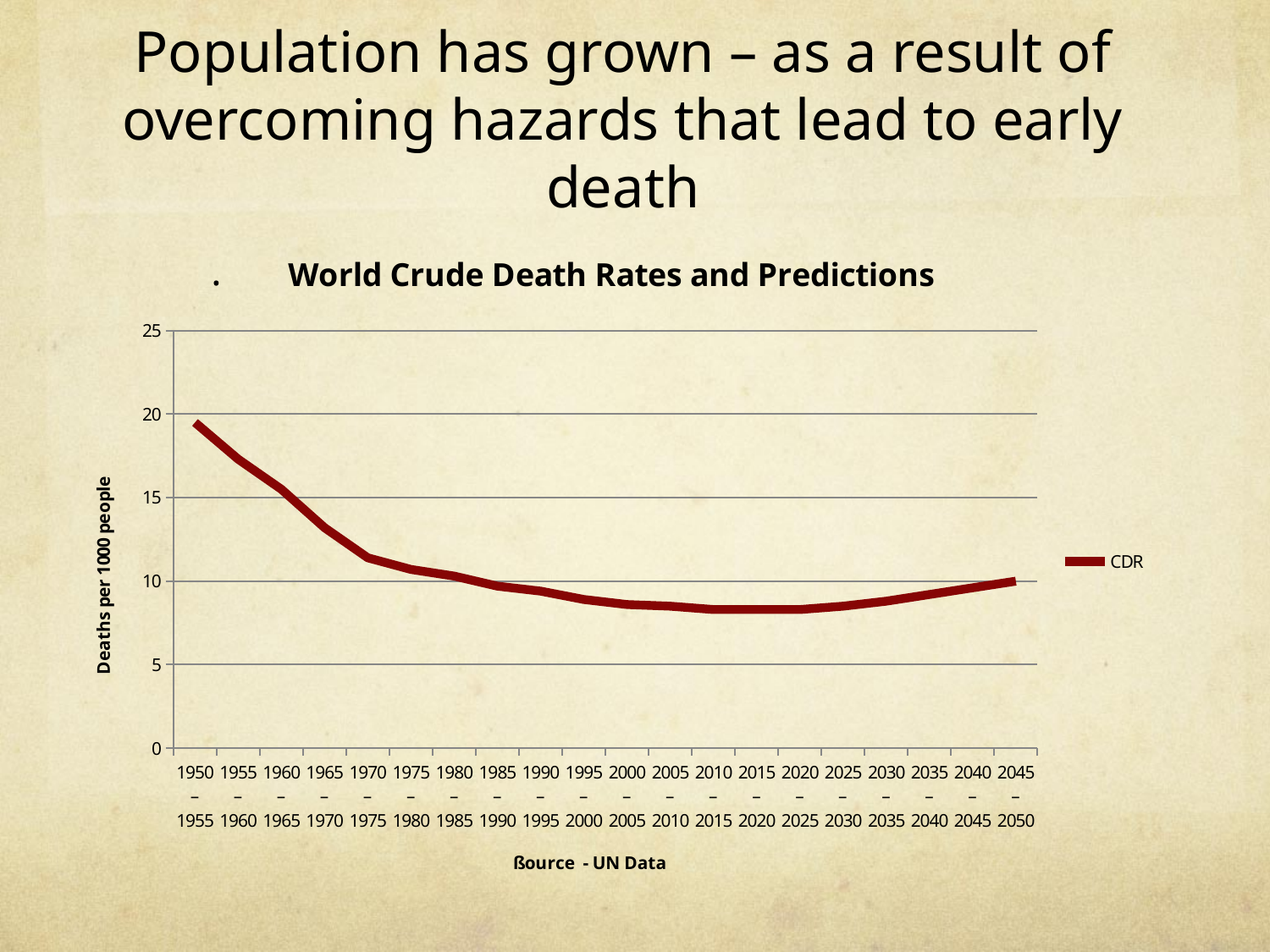
Is the value for 2045 – 2050 greater or less than 15? less How many time periods are plotted along the x axis? 20 What series name does the legend show? CDR Is the value for 2010 – 2015 greater or less than 10? less Is the value for 1950 – 1955 greater or less than 15? greater Does the crude death rate rise or fall between 1950 – 1955 and 2010 – 2015? fall Which period has the highest crude death rate? 1950 – 1955 Which is larger, the value for 1980 – 1985 or the value for 2000 – 2005? 1980 – 1985 How many series does the legend list? 1 What is the title of the chart? World Crude Death Rates and Predictions What kind of chart is shown on the slide? Line chart